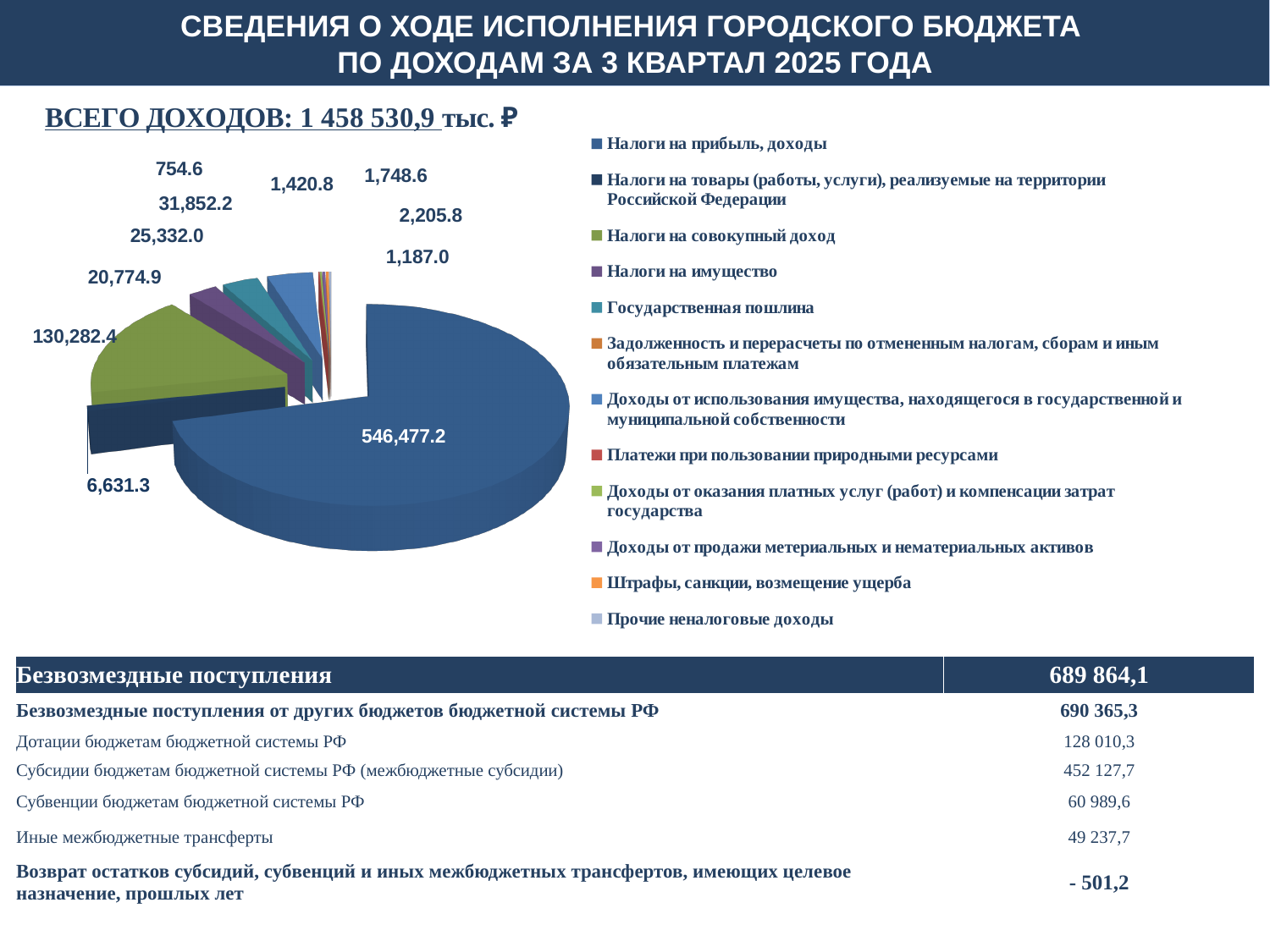
What total income (ВСЕГО ДОХОДОВ) is stated above the pie chart? 1 458 530,9 тыс. ₽ Which is larger, the slice for Государственная пошлина or the slice for Налоги на имущество? Государственная пошлина What is the last entry listed in the chart legend? Прочие неналоговые доходы What is the value shown for the green slice, Налоги на совокупный доход? 130,282.4 What is the difference between the largest slice (546,477.2) and the slice for Налоги на совокупный доход (130,282.4)? 416,194.8 How many data labels are printed on the pie chart? 11 What is the smallest value labelled on the pie chart? 754.6 Which category has the largest slice in the pie chart? Налоги на прибыль, доходы What is the value shown for the largest slice of the pie chart? 546,477.2 How many entries does the chart legend list? 12 What kind of chart is shown on the slide? pie chart